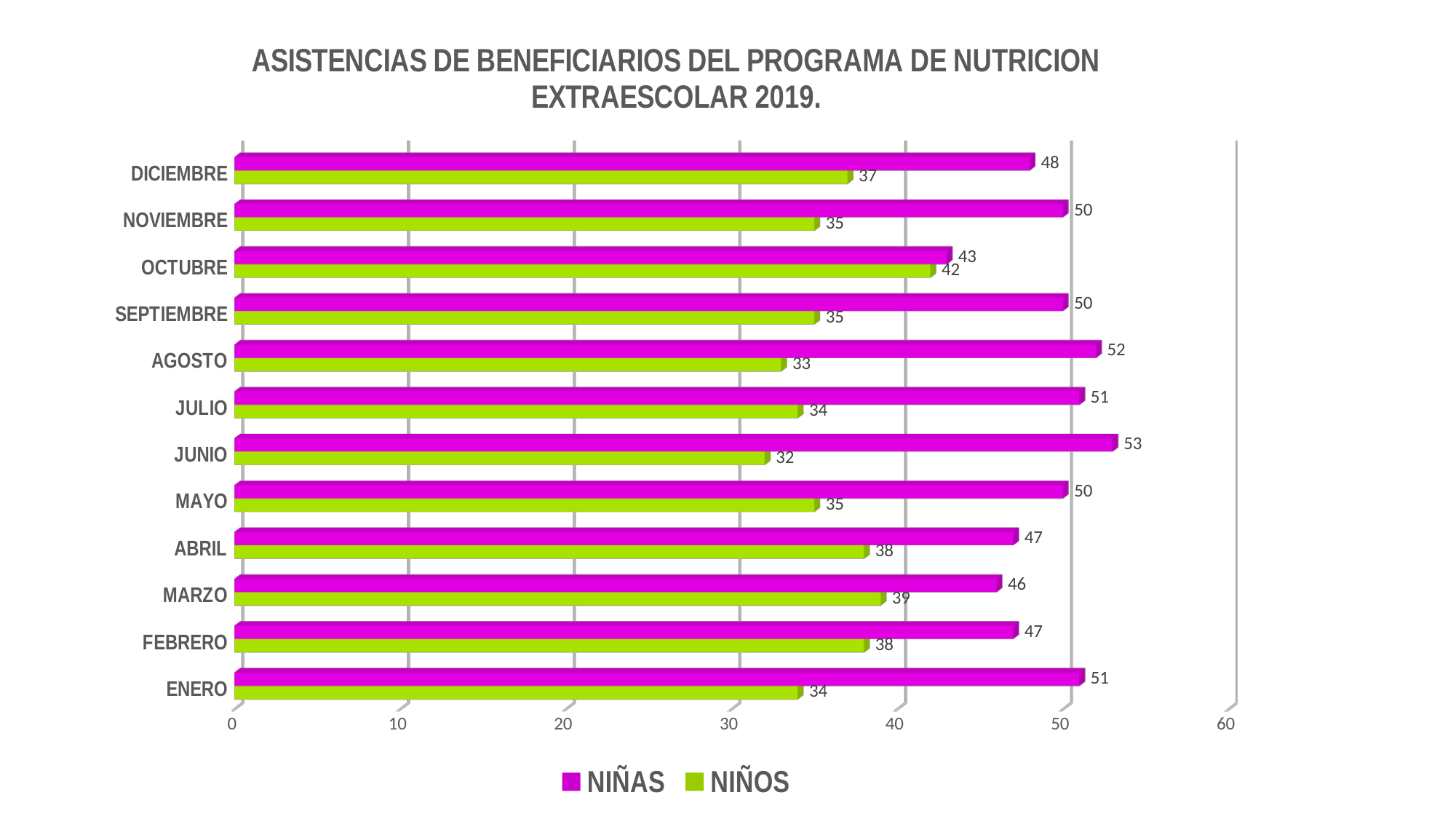
Which month has the lowest NIÑOS value? JUNIO How many series does the legend list? 2 What is the NIÑOS value for OCTUBRE? 42 Which month has the highest NIÑAS value? JUNIO What kind of chart is shown on the slide? Bar chart What colour are the NIÑOS bars? Green How many months are shown on the chart? 12 What is the difference between the NIÑAS and NIÑOS values for AGOSTO? 19 Which is larger for MARZO, the NIÑAS value or the NIÑOS value? NIÑAS What is the NIÑOS value for DICIEMBRE? 37 Which month has the lowest NIÑAS value? OCTUBRE What is the NIÑAS value for JUNIO? 53